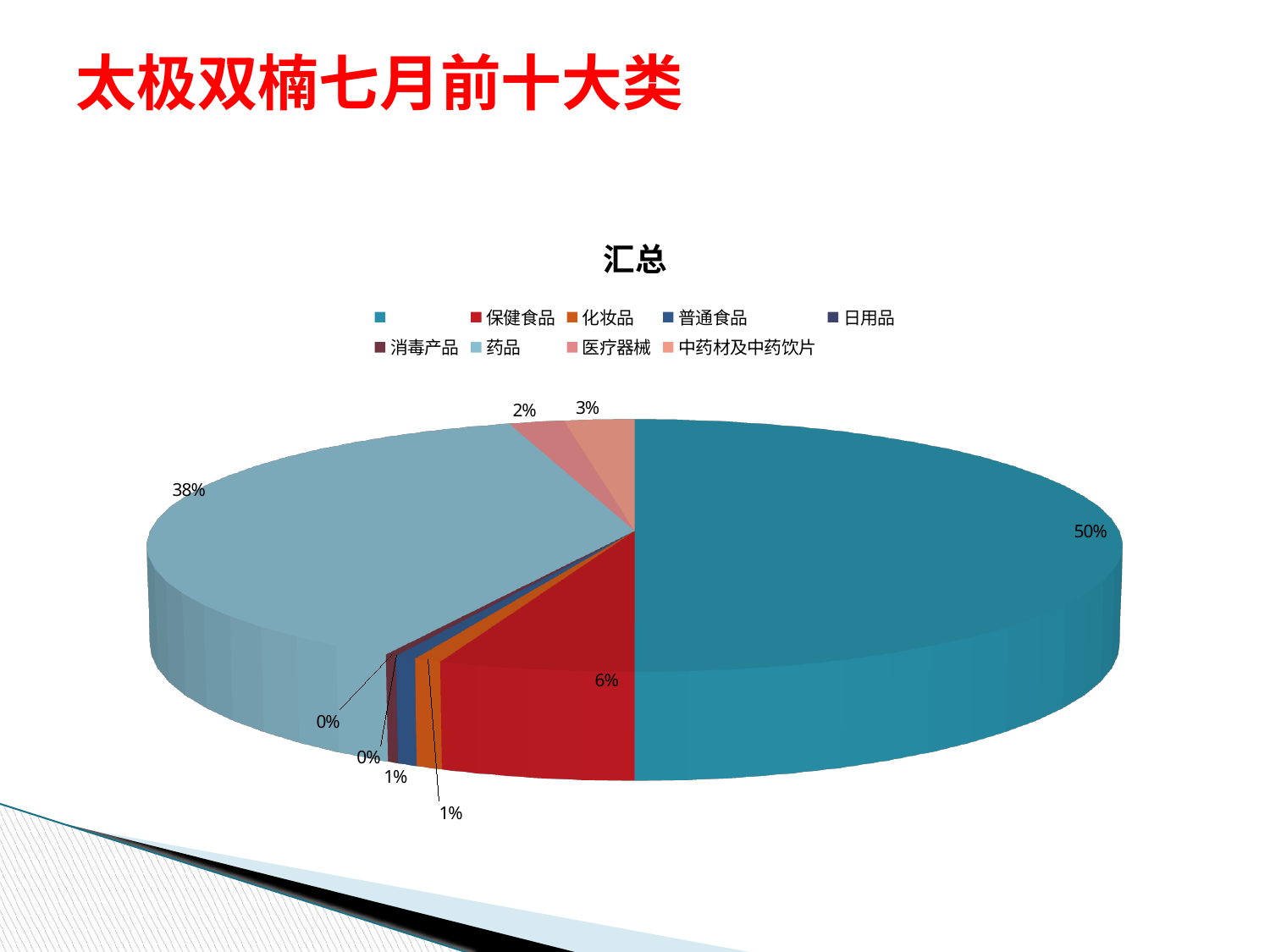
By how many percentage points does 中药材及中药饮片 exceed 医疗器械? 1 percentage point Which slice is larger, 药品 or 保健食品? 药品 What share of the pie does 医疗器械 account for? 2% What share of the pie does 化妆品 account for? 1% What share of the pie does 药品 account for? 38% How many percentage data labels are shown on the pie? 9 What is the title of the chart? 汇总 What kind of chart is shown on the slide? Pie chart What is the largest percentage label shown on the pie? 50% By how many percentage points does 药品 exceed 保健食品? 32 percentage points